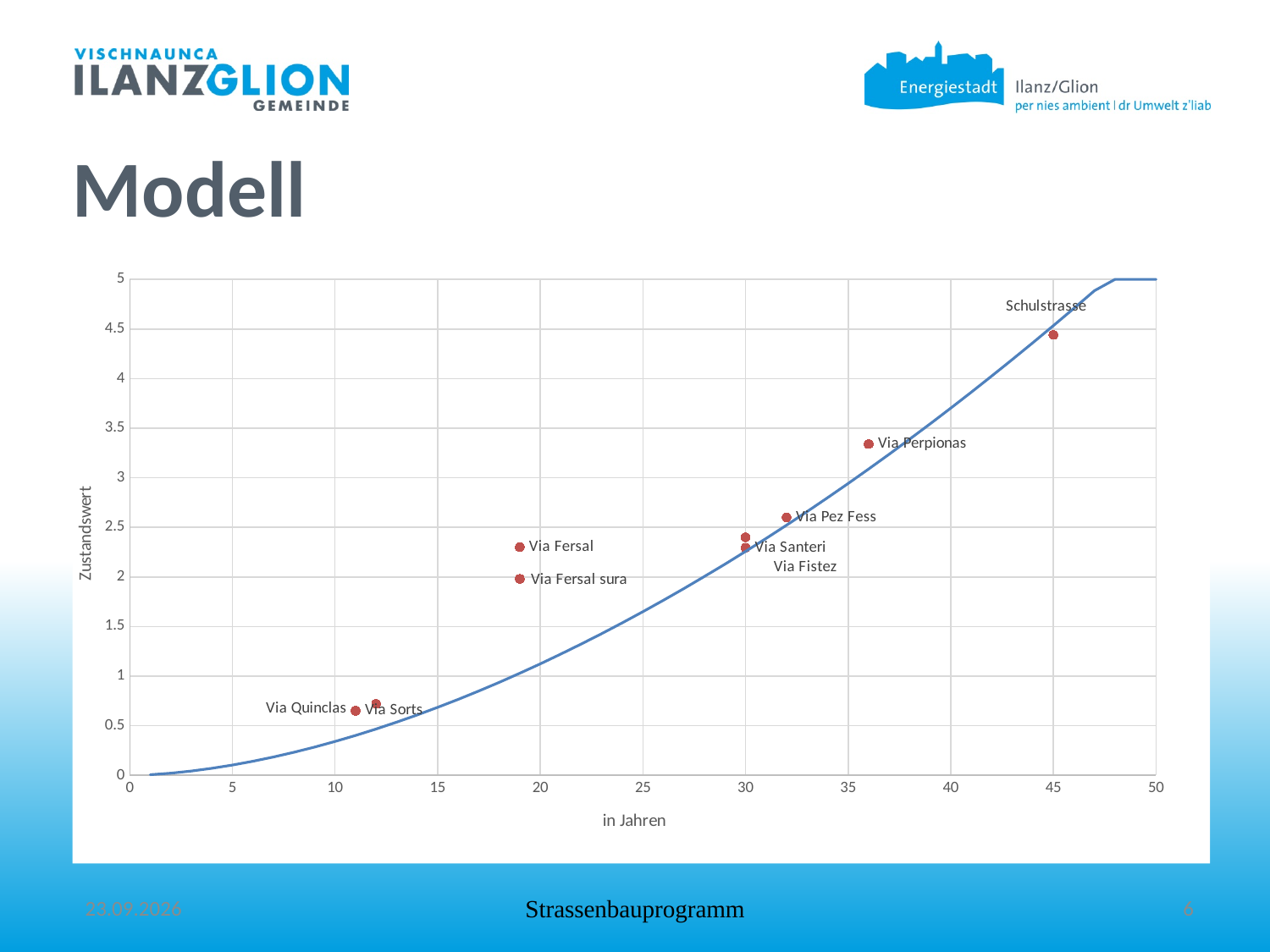
Does the model curve rise or fall as the years increase along the x axis? rise Which has a higher Zustandswert, Schulstrasse or Via Perpionas? Schulstrasse How many labeled street points are plotted on the chart? 9 What is the label of the vertical axis? Zustandswert Is the Zustandswert for Via Quinclas greater or less than 1? less What kind of chart is shown on the slide? scatter chart Which has a higher Zustandswert, Via Pez Fess or Via Fersal sura? Via Pez Fess Which labeled street has the highest Zustandswert? Schulstrasse Is the Zustandswert for Schulstrasse greater or less than 4? greater Is the Zustandswert for Via Perpionas greater or less than 3? greater What is the title of the chart on the slide? Modell